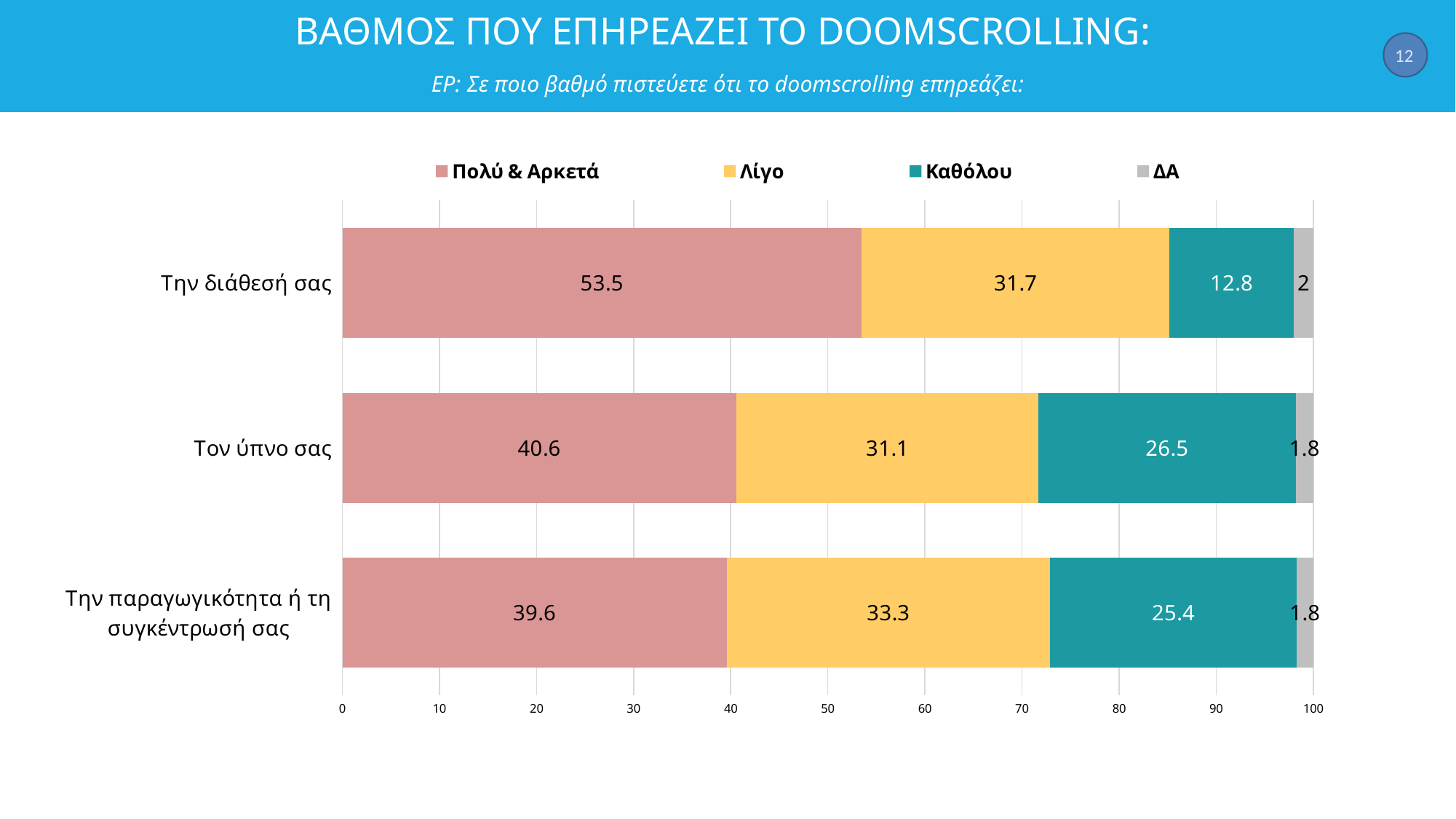
What is the difference between the 'Πολύ & Αρκετά' values for 'Την διάθεσή σας' and 'Τον ύπνο σας'? 12.9 Which category has the highest 'Πολύ & Αρκετά' value? Την διάθεσή σας What kind of chart is shown on the slide? Stacked bar chart Which is larger: the 'Καθόλου' value for 'Τον ύπνο σας' or for 'Την παραγωγικότητα ή τη συγκέντρωσή σας'? Τον ύπνο σας What is the value of 'Λίγο' for 'Την παραγωγικότητα ή τη συγκέντρωσή σας'? 33.3 What is the total of the stacked bar for 'Τον ύπνο σας'? 100 What is the value of 'Πολύ & Αρκετά' for 'Την διάθεσή σας'? 53.5 What is the value of 'Καθόλου' for 'Τον ύπνο σας'? 26.5 Which category has the lowest 'Καθόλου' value? Την διάθεσή σας How many categories are shown on the chart? 3 What is the value of 'ΔΑ' for 'Την διάθεσή σας'? 2 How many series does the legend list? 4